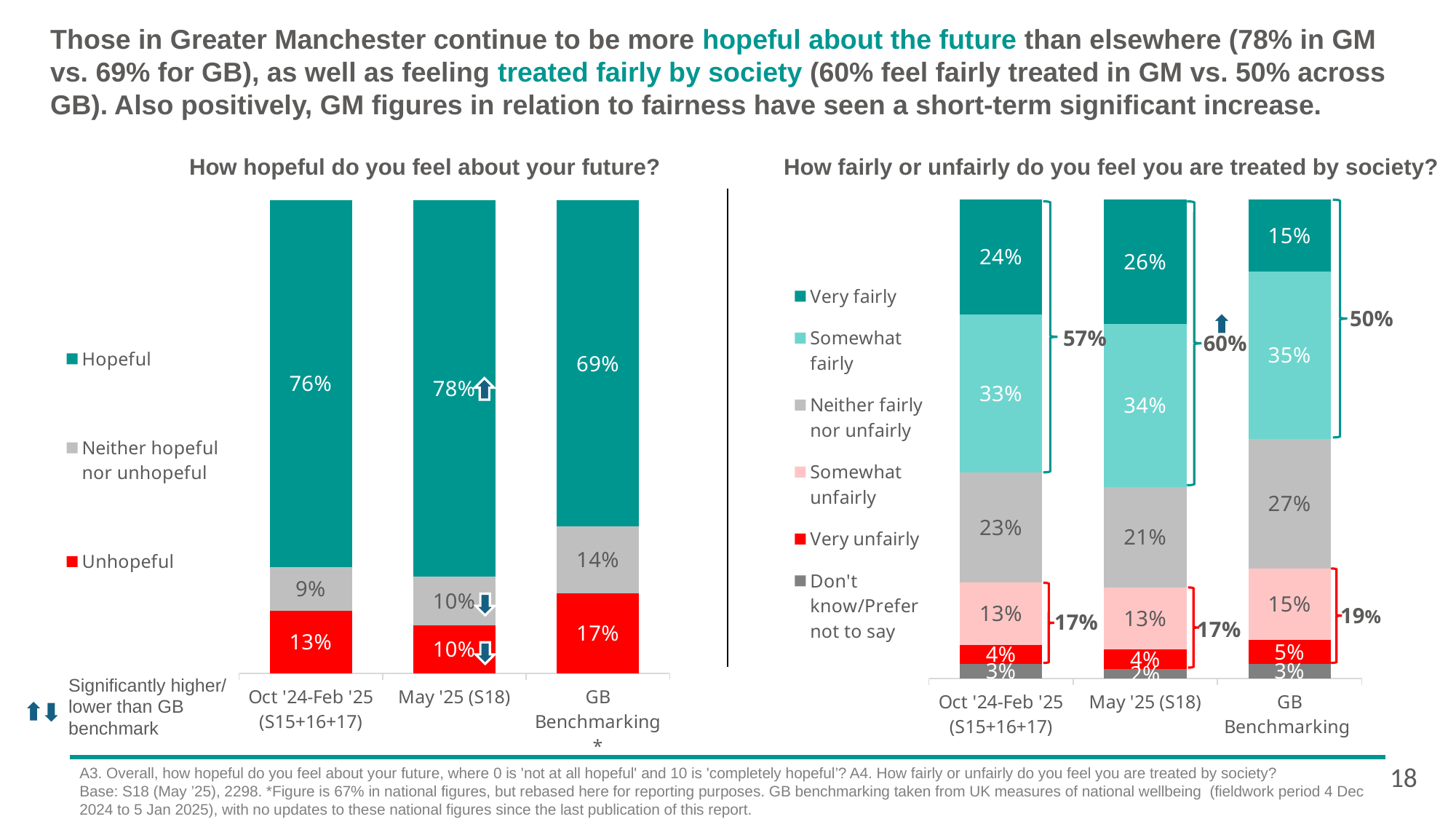
In the 'How fairly or unfairly do you feel you are treated by society?' chart, what is the Very fairly value for May '25 (S18)? 26% In the 'How fairly or unfairly do you feel you are treated by society?' chart, what is the Somewhat fairly value for GB Benchmarking? 35% What type of chart is 'How fairly or unfairly do you feel you are treated by society?' Stacked bar chart In the 'How fairly or unfairly do you feel you are treated by society?' chart, is the Neither fairly nor unfairly value larger for Oct '24-Feb '25 (S15+16+17) or GB Benchmarking? GB Benchmarking In the 'How fairly or unfairly do you feel you are treated by society?' chart, which category has the lowest Very fairly percentage? GB Benchmarking In the 'How hopeful do you feel about your future?' chart, what is the difference between the Hopeful values for May '25 (S18) and GB Benchmarking? 9 percentage points In the 'How hopeful do you feel about your future?' chart, what percentage were Hopeful in May '25 (S18)? 78% In the 'How hopeful do you feel about your future?' chart, how many series does the legend list? 3 In the 'How fairly or unfairly do you feel you are treated by society?' chart, how many series does the legend list? 6 In the 'How hopeful do you feel about your future?' chart, what is the Unhopeful value for GB Benchmarking? 17% In the 'How hopeful do you feel about your future?' chart, which category has the highest Hopeful percentage? May '25 (S18) In the 'How fairly or unfairly do you feel you are treated by society?' chart, how many categories are shown on the x axis? 3